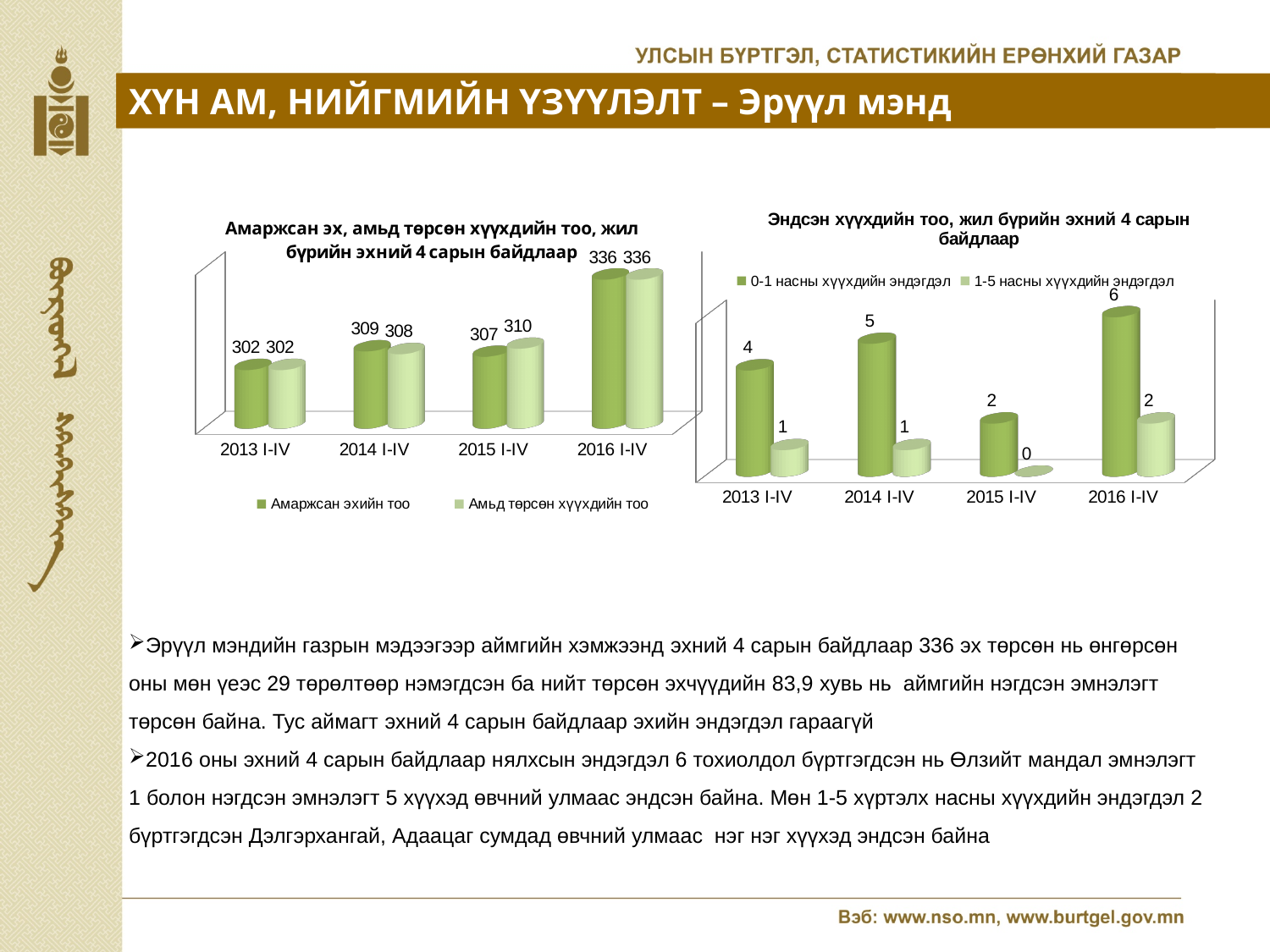
In the left chart, what is the value of Амаржсан эхийн тоо for 2016 I-IV? 336 In the left chart, how many periods are shown on the x axis? 4 In the right chart, what is the difference between 0-1 насны хүүхдийн эндэгдэл and 1-5 насны хүүхдийн эндэгдэл in 2016 I-IV? 4 In the left chart, what is the value of Амьд төрсөн хүүхдийн тоо for 2015 I-IV? 310 What kind of chart is the right chart? Bar chart In the right chart, which is larger in 2016 I-IV: 0-1 насны хүүхдийн эндэгдэл or 1-5 насны хүүхдийн эндэгдэл? 0-1 насны хүүхдийн эндэгдэл In the left chart, which period has the highest value for Амаржсан эхийн тоо? 2016 I-IV In the right chart, what is the value of 0-1 насны хүүхдийн эндэгдэл for 2014 I-IV? 5 In the right chart, what is the value of 1-5 насны хүүхдийн эндэгдэл for 2015 I-IV? 0 In the left chart, what is the difference between Амаржсан эхийн тоо in 2016 I-IV and 2013 I-IV? 34 In the right chart, which period has the lowest value for 0-1 насны хүүхдийн эндэгдэл? 2015 I-IV In the left chart, how many series does the legend list? 2